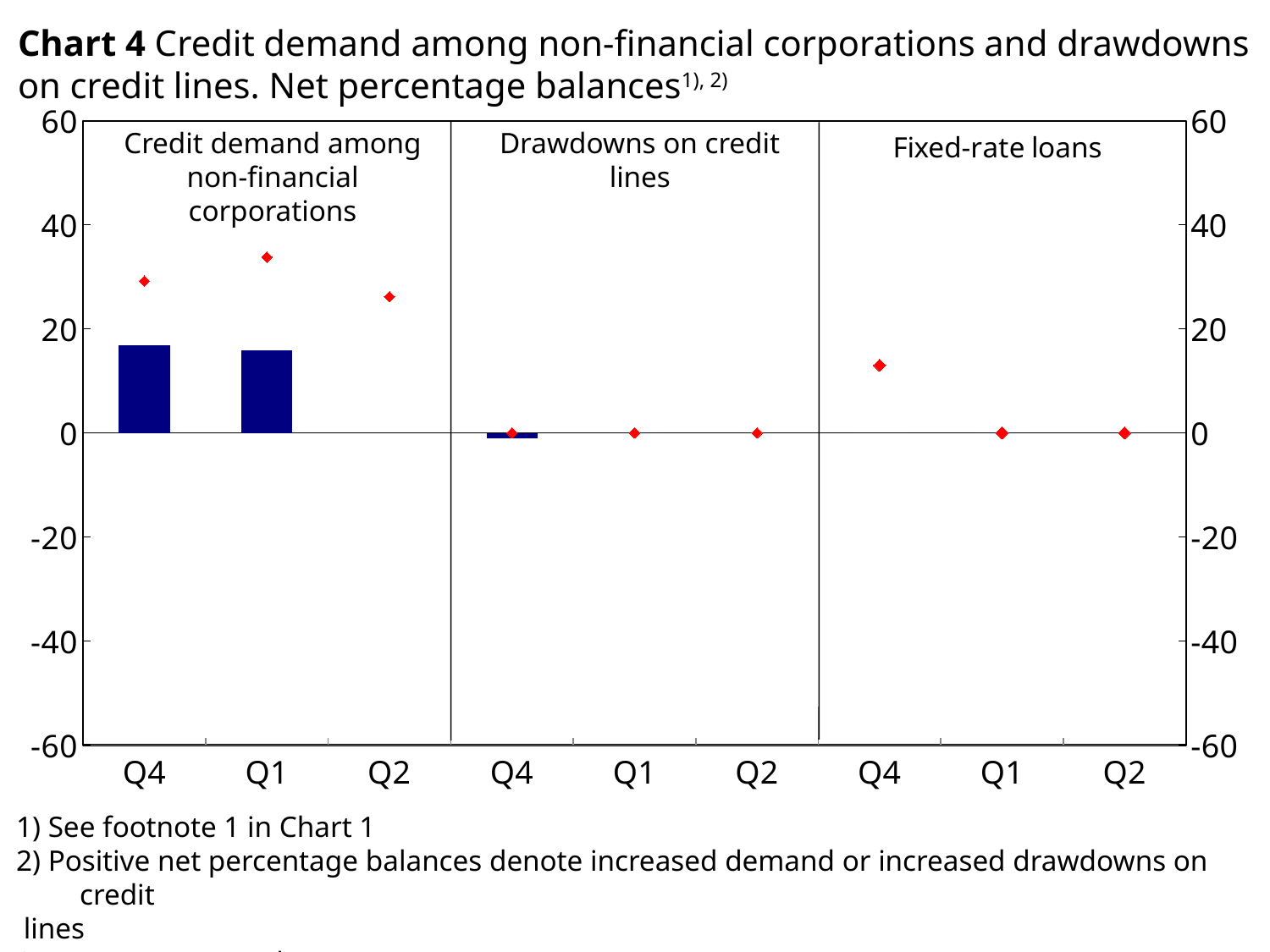
In the 'Fixed-rate loans' panel, is the red diamond for Q4 greater or less than 20? less In the 'Credit demand among non-financial corporations' panel, which quarter has the highest red diamond value? Q1 In the 'Credit demand among non-financial corporations' panel, is the bar for Q4 greater or less than 20? less How many panels (sections) does the chart have? 3 What kind of chart is shown on the slide? combination chart with bars and diamond markers What is the title of the third panel of the chart? Fixed-rate loans In the 'Fixed-rate loans' panel, is the red diamond for Q4 greater or less than 0? greater In the 'Credit demand among non-financial corporations' panel, which quarter has the lowest red diamond value? Q2 How many quarters are shown on the x axis within each panel? 3